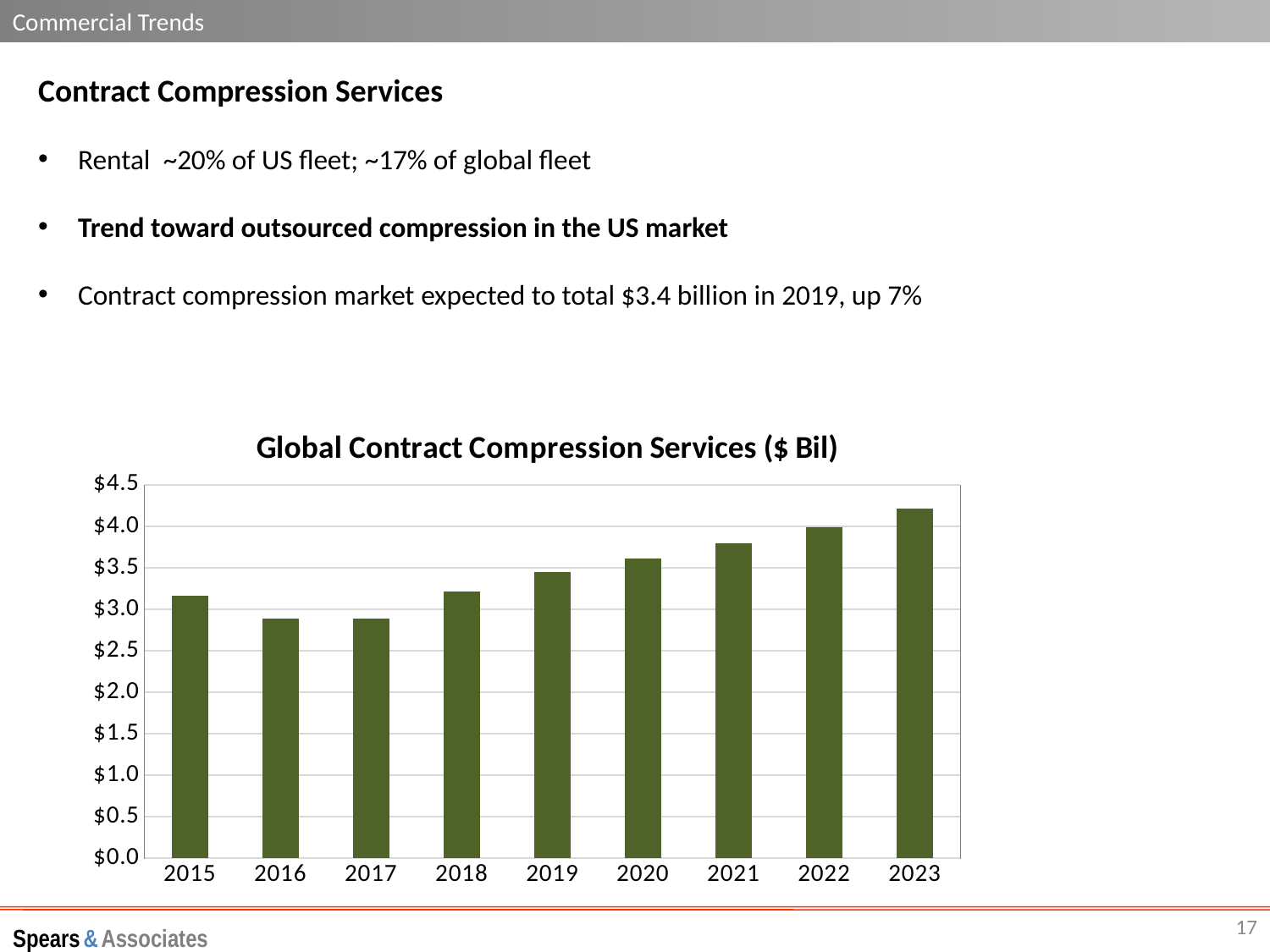
Which year has the highest value in the chart? 2023 Which is larger, the value for 2018 or the value for 2021? 2021 Is the value for 2021 greater or less than $3.5? greater How many years are shown on the x axis of the chart? 9 Is the value for 2016 greater or less than $3.0? less Do the values rise or fall from 2017 to 2023? rise What kind of chart is shown on the slide? bar chart Is the value for 2023 greater or less than $4.0? greater Which is larger, the value for 2015 or the value for 2023? 2023 What is the title of the chart? Global Contract Compression Services ($ Bil)